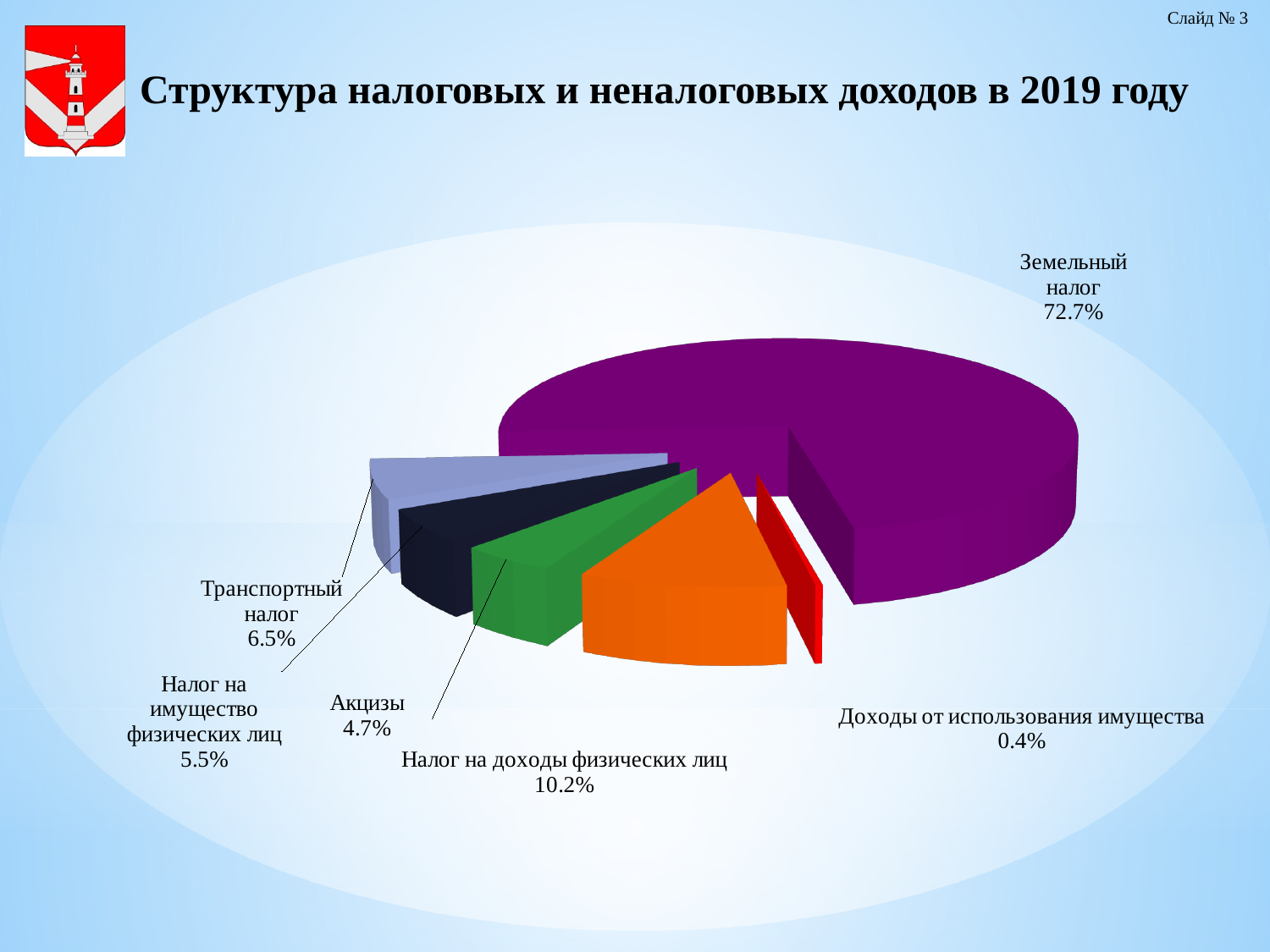
What kind of chart is shown on the slide? Pie chart Which is larger: Транспортный налог or Налог на имущество физических лиц? Транспортный налог What is the share of Транспортный налог? 6.5% What is the share of Доходы от использования имущества? 0.4% Which category has the smallest share of the pie? Доходы от использования имущества What is the share of Налог на доходы физических лиц? 10.2% What is the difference in percentage points between Земельный налог and Налог на доходы физических лиц? 62.5 How many slices does the pie chart have? 6 What is the share of Земельный налог in the pie chart? 72.7% What is the title of the chart on the slide? Структура налоговых и неналоговых доходов в 2019 году Which category has the largest share of the pie? Земельный налог What is the share of Акцизы? 4.7%